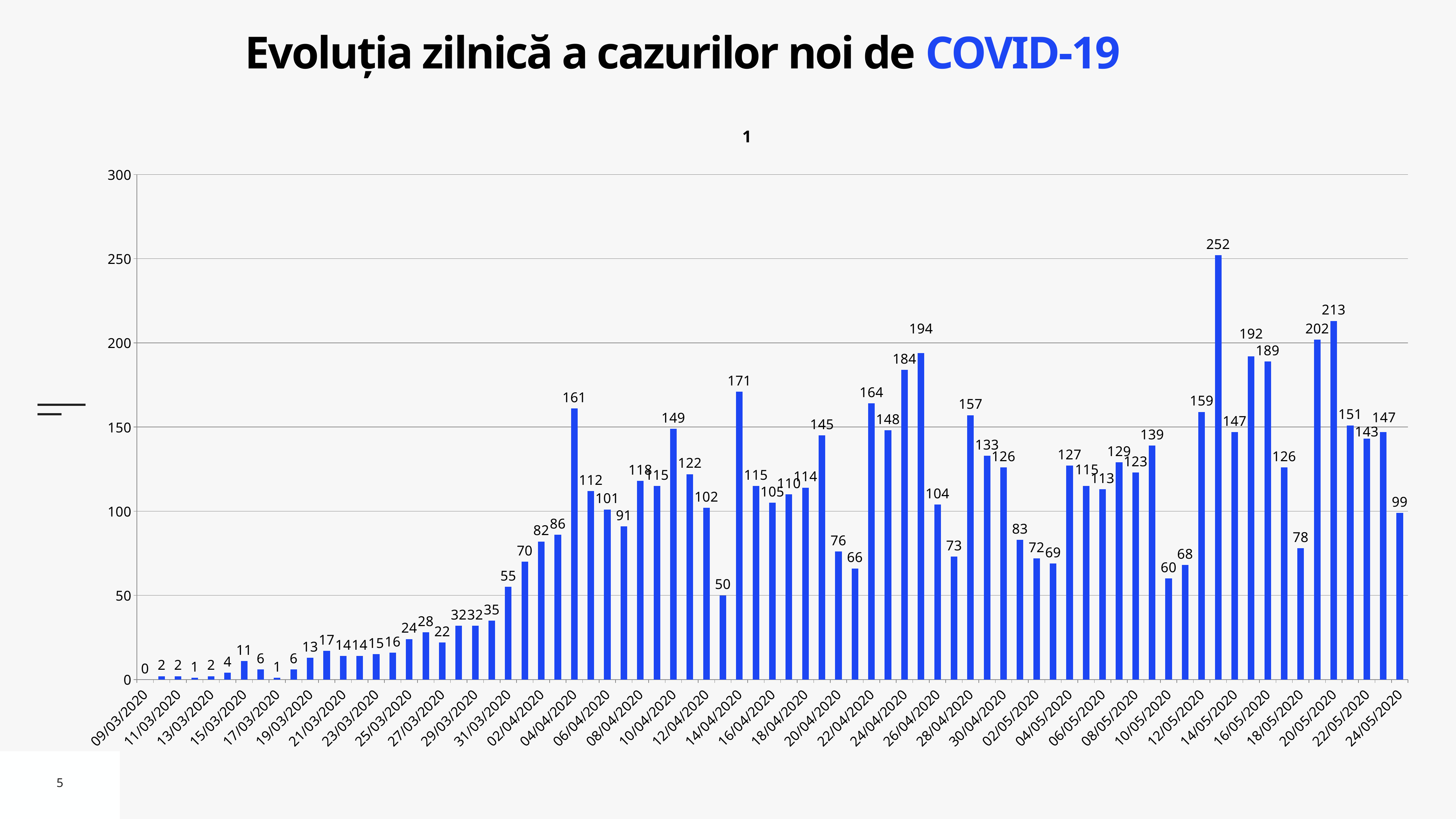
What is the value for 24/05/2020? 99 Do the values rise or fall from 09/03/2020 to 31/03/2020? rise Which date has the larger value, 14/04/2020 or 22/04/2020? 14/04/2020 What is the value for 20/05/2020? 213 What is the highest daily value shown on the chart? 252 Which date has the lowest value on the chart? 09/03/2020 What kind of chart is shown on the slide? bar chart What is the difference between the values for 20/05/2020 and 24/05/2020? 114 What is the value for 04/04/2020? 161 What is the value for 10/05/2020? 60 Is the value for 16/05/2020 greater or less than 150? greater What is the title of the slide? Evoluția zilnică a cazurilor noi de COVID-19